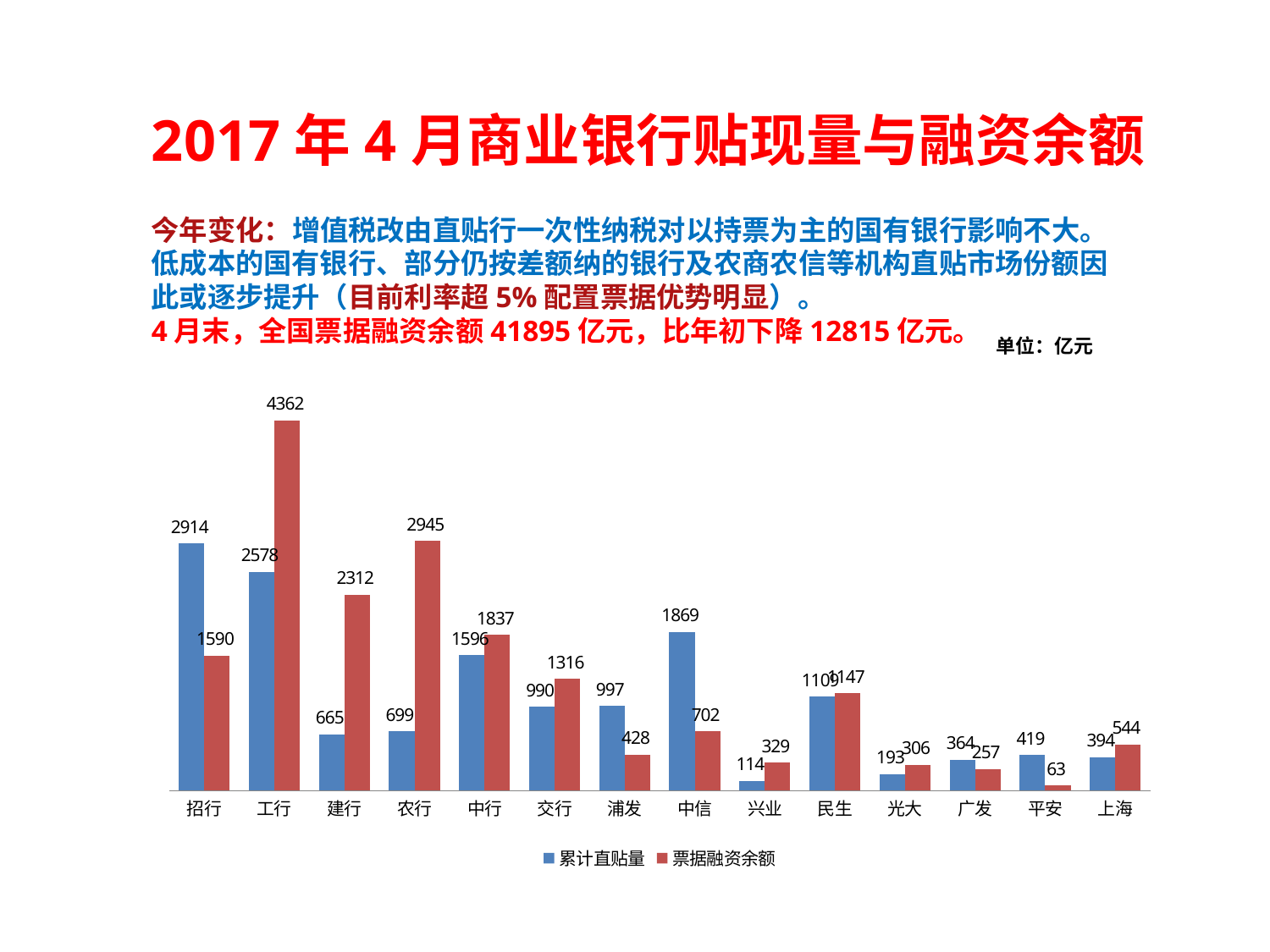
What type of chart is shown on the slide? bar chart Which bank has the highest 票据融资余额? 工行 For 农行, how much larger is 票据融资余额 than 累计直贴量? 2246 Which bank has the lowest 票据融资余额? 平安 What is the 票据融资余额 value for 工行? 4362 What is the 累计直贴量 value for 招行? 2914 How many banks are shown on the x axis of the chart? 14 Which bank has the highest 累计直贴量? 招行 How many series does the chart legend list? 2 For 浦发, which is larger: 累计直贴量 or 票据融资余额? 累计直贴量 What is the 累计直贴量 value for 中信? 1869 Which bank has the lowest 累计直贴量? 兴业